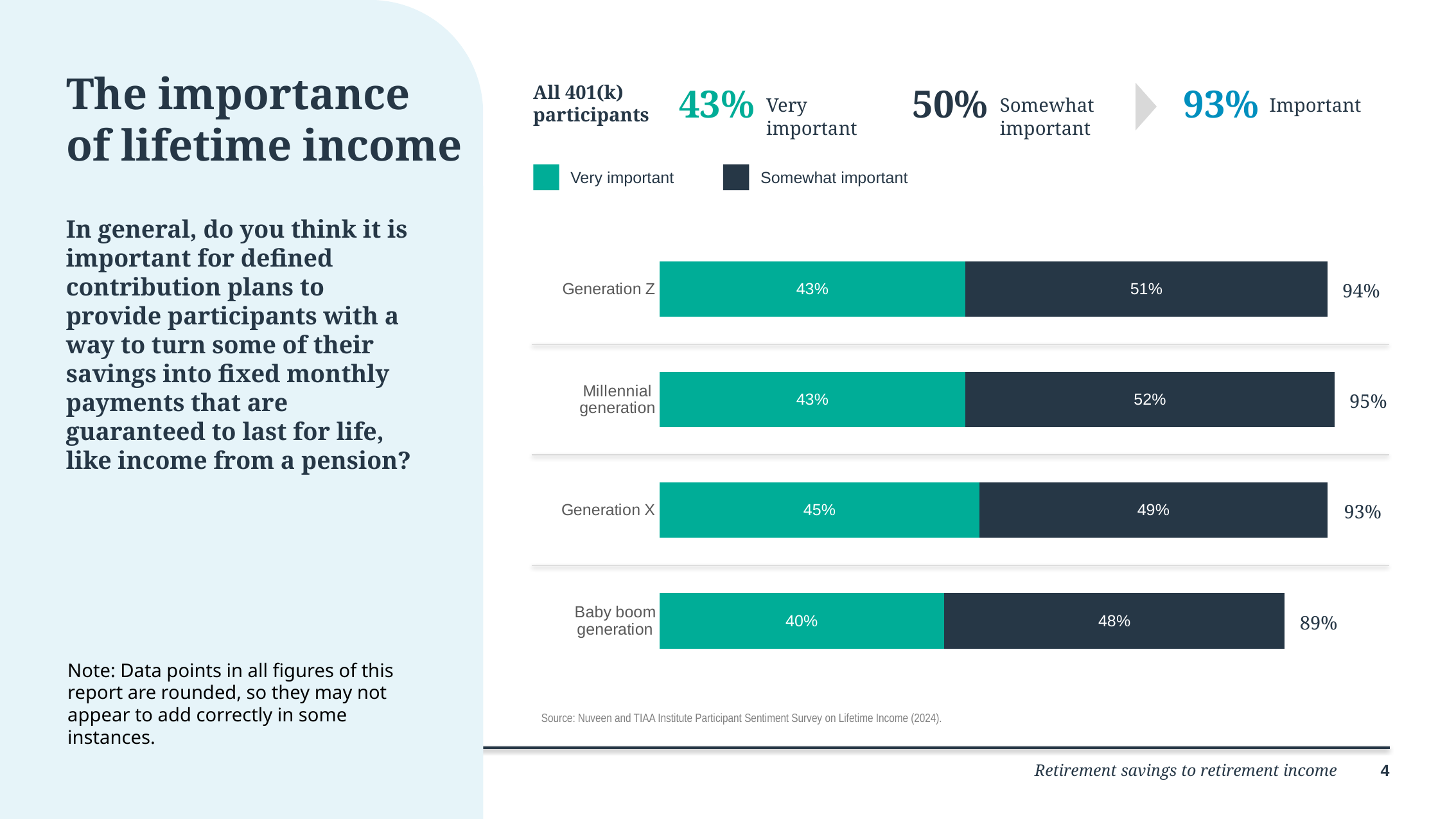
What is the combined 'Important' total shown for the Millennial generation? 95% What is the difference between the 'Somewhat important' values for the Millennial generation and Generation X? 3% Which generation has the highest 'Somewhat important' share? Millennial generation Is the 'Somewhat important' value larger for Generation Z or for the Baby boom generation? Generation Z Which generation has the lowest 'Very important' share? Baby boom generation What is the 'Very important' value for Generation X? 45% Which generation has the highest 'Very important' share? Generation X What percentage of the Baby boom generation said lifetime income is somewhat important? 48% What percentage of Generation Z participants said lifetime income is very important? 43% How many generation categories are shown in the chart? 4 How many series does the legend list? 2 What is the combined 'Important' total shown for the Baby boom generation? 89%